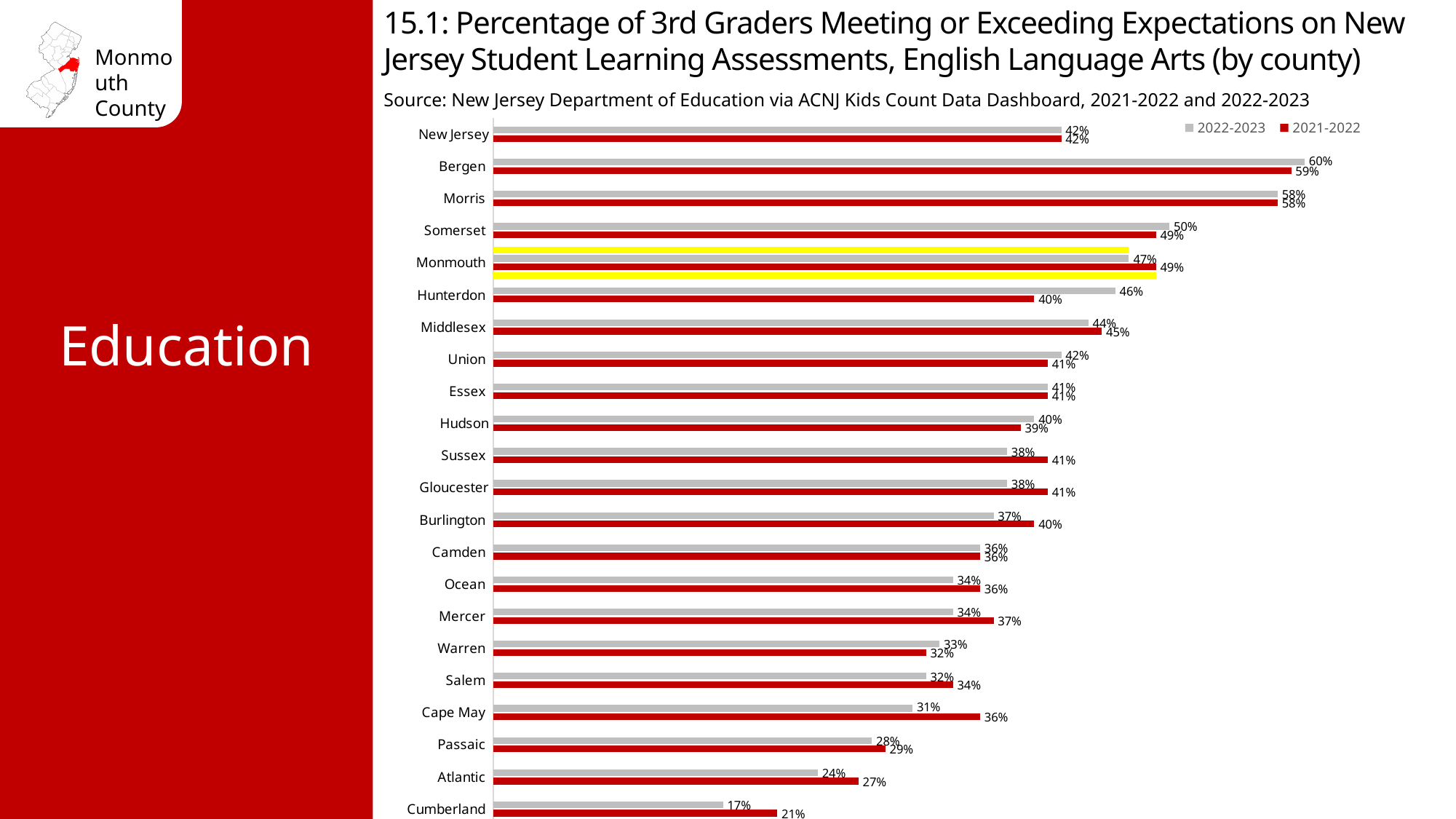
How many series does the legend list? 2 What is the 2021-2022 value for Cumberland? 21% Which county has the lowest 2022-2023 value? Cumberland How many categories (counties plus New Jersey) are shown on the chart? 22 Which county has the highest 2022-2023 value? Bergen Which series is shown in red in the legend? 2021-2022 Which is larger for Cape May: the 2022-2023 value or the 2021-2022 value? 2021-2022 What kind of chart is shown on the slide? bar chart What is the 2022-2023 value for Monmouth? 47% What is the difference between the 2022-2023 and 2021-2022 values for Hunterdon? 6% What is the 2021-2022 value for Monmouth? 49% What is the 2022-2023 value for Bergen? 60%